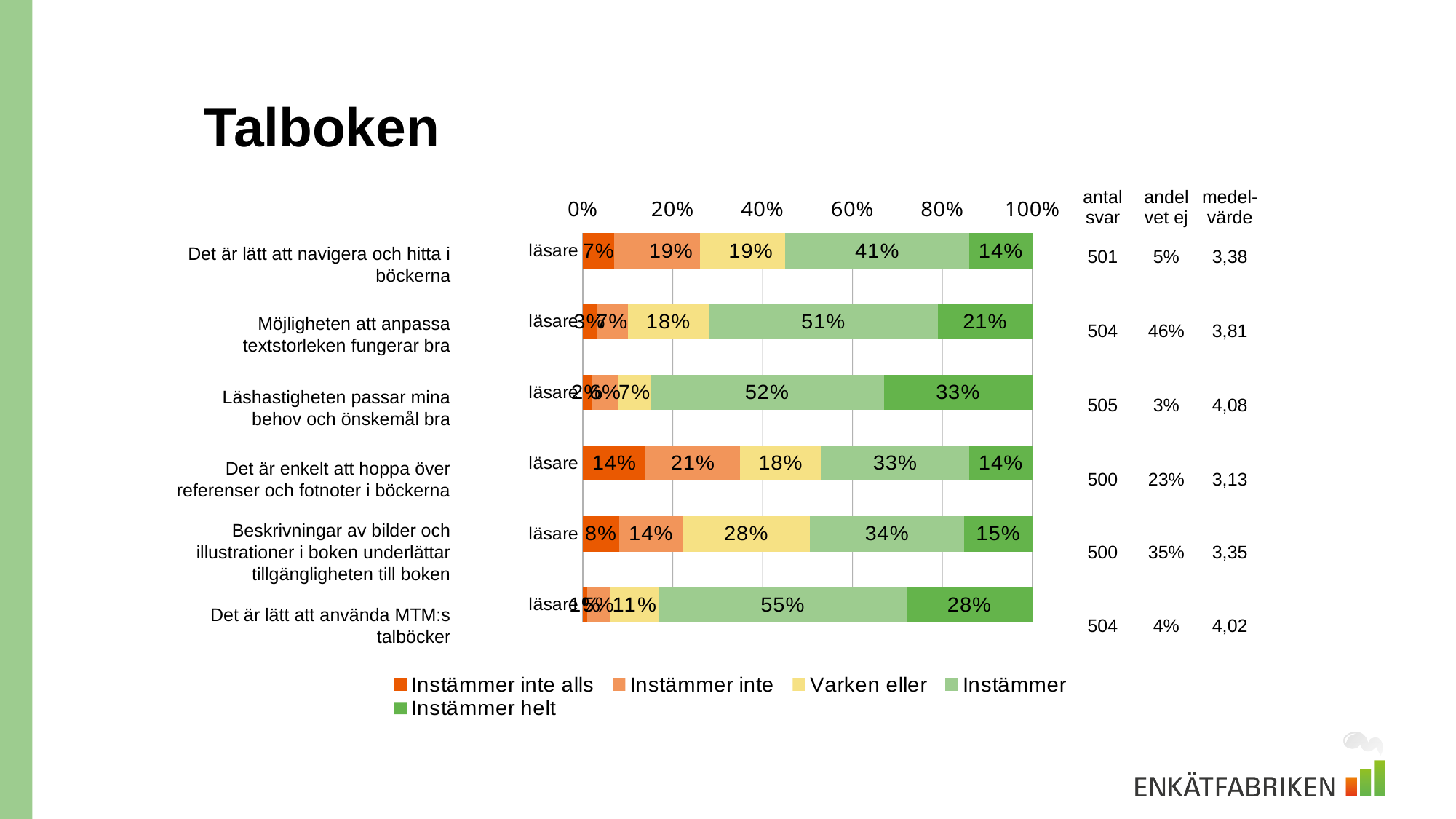
What is the first entry in the chart legend? Instämmer inte alls What is the difference in the "Instämmer" share between "Läshastigheten passar mina behov och önskemål bra" and "Det är lätt att navigera och hitta i böckerna"? 11 percentage points Which has the larger "Varken eller" share: "Beskrivningar av bilder och illustrationer i boken underlättar tillgängligheten till boken" or "Det är lätt att navigera och hitta i böckerna"? Beskrivningar av bilder och illustrationer i boken underlättar tillgängligheten till boken What is the "Instämmer helt" share for "Läshastigheten passar mina behov och önskemål bra"? 33% What is the "Instämmer" share for "Det är lätt att använda MTM:s talböcker"? 55% How many series does the legend list? 5 How many statements (bars) are plotted in the chart? 6 Which statement has the highest "Instämmer inte alls" share? Det är enkelt att hoppa över referenser och fotnoter i böckerna Which statement has the highest "Instämmer helt" share? Läshastigheten passar mina behov och önskemål bra What is the "Instämmer inte alls" share for "Det är enkelt att hoppa över referenser och fotnoter i böckerna"? 14% What kind of chart is shown on the slide? bar chart What is the "Instämmer inte" share for "Beskrivningar av bilder och illustrationer i boken underlättar tillgängligheten till boken"? 14%